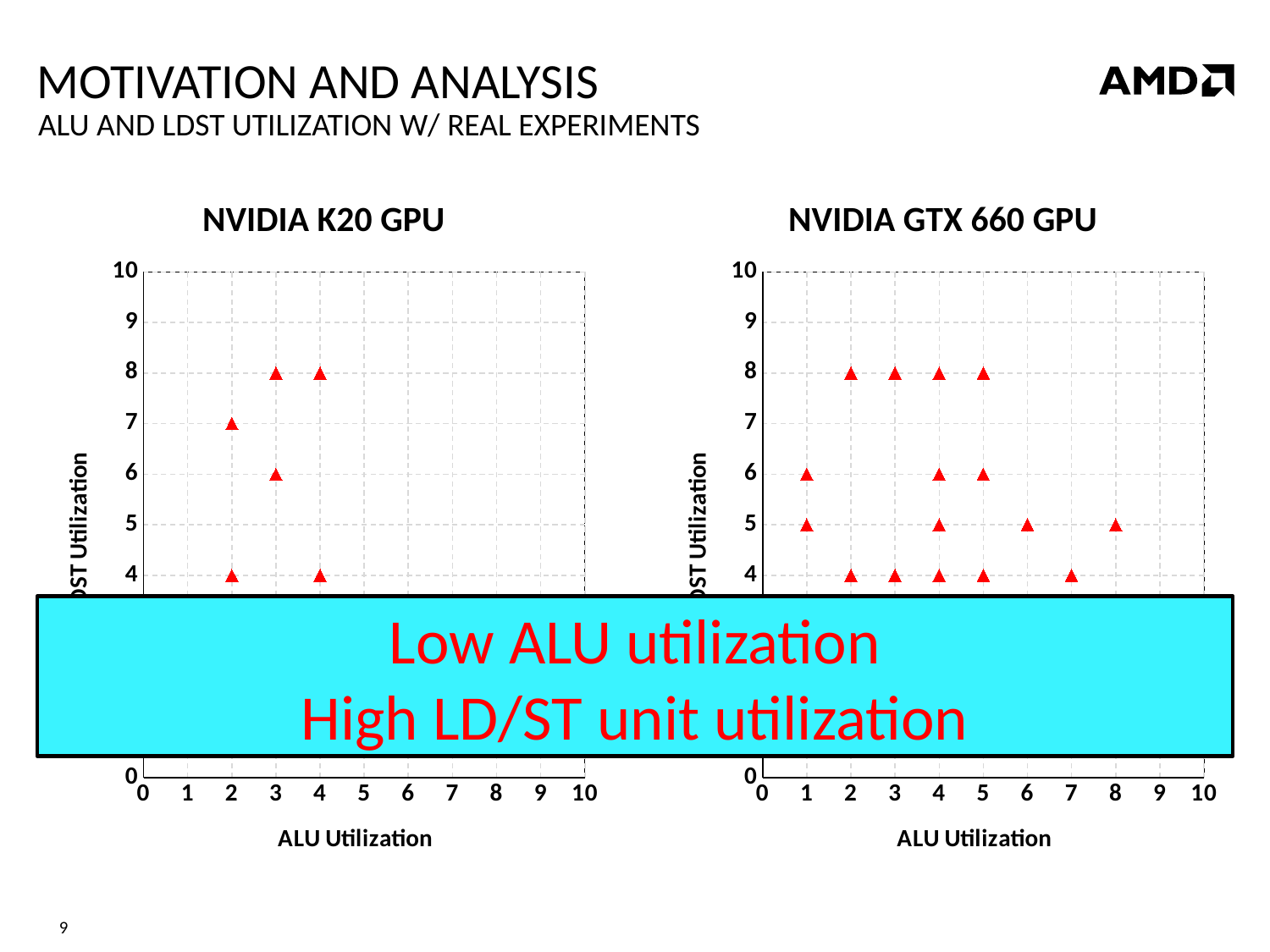
In the NVIDIA GTX 660 GPU chart, how many points are plotted at an LDST Utilization of 5? 4 In the NVIDIA K20 GPU chart, how many points are plotted at an LDST Utilization of 8? 2 In the NVIDIA K20 GPU chart, what is the highest LDST Utilization value reached by any plotted point? 8 In the NVIDIA GTX 660 GPU chart, what is the largest ALU Utilization value at which a point is plotted? 8 In the NVIDIA K20 GPU chart, is the LDST Utilization of the point at ALU Utilization 2 with the highest LDST value greater or less than 5? greater In the NVIDIA K20 GPU chart, what is the label of the x axis? ALU Utilization In the NVIDIA K20 GPU chart, what is the LDST Utilization of the point plotted at ALU Utilization 3 with the lower LDST value of the two visible points at that x? 6 In the NVIDIA GTX 660 GPU chart, how many points are plotted at an LDST Utilization of 8? 4 What kind of chart is the NVIDIA K20 GPU chart? scatter chart What is the title of the chart on the right side of the slide? NVIDIA GTX 660 GPU In the NVIDIA GTX 660 GPU chart, what is the LDST Utilization of the point plotted at ALU Utilization 7? 4 In the NVIDIA GTX 660 GPU chart, what is the highest LDST Utilization value reached by any plotted point? 8